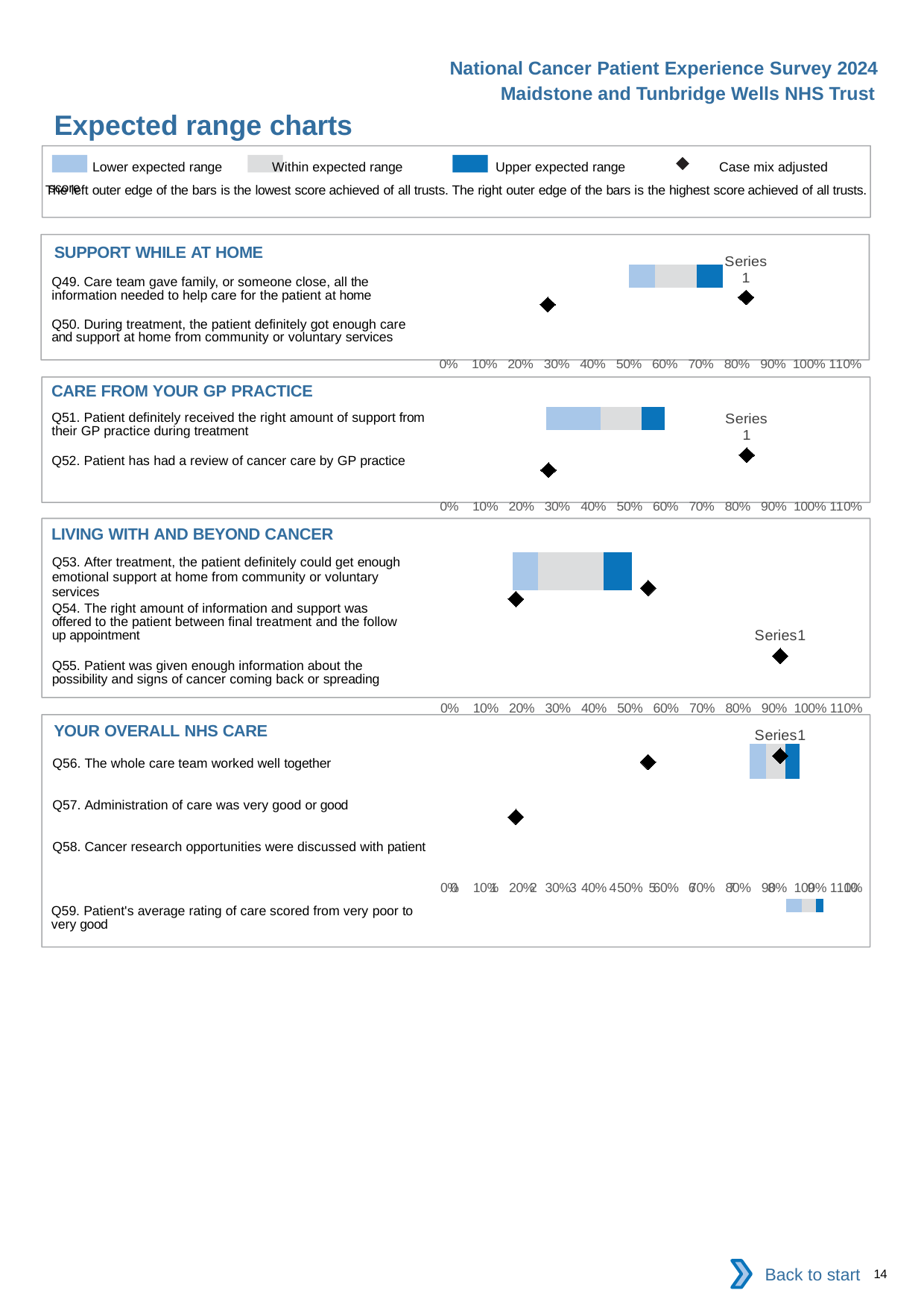
In the SUPPORT WHILE AT HOME chart, is the leftmost case mix adjusted score marker greater or less than 50%? less What is the highest tick label shown on the x axis of the CARE FROM YOUR GP PRACTICE chart? 110% What kind of chart is used in the SUPPORT WHILE AT HOME section? bar chart In the LIVING WITH AND BEYOND CANCER chart, is the leftmost case mix adjusted score marker greater or less than 30%? less How many survey questions are listed in the YOUR OVERALL NHS CARE section? 4 In the CARE FROM YOUR GP PRACTICE chart, is the rightmost case mix adjusted score marker greater or less than 70%? greater How many survey questions are listed in the SUPPORT WHILE AT HOME section? 2 How many survey questions are listed in the LIVING WITH AND BEYOND CANCER section? 3 Which legend entry is shown with the dark blue colour? Upper expected range How many entries does the legend at the top of the slide list? 4